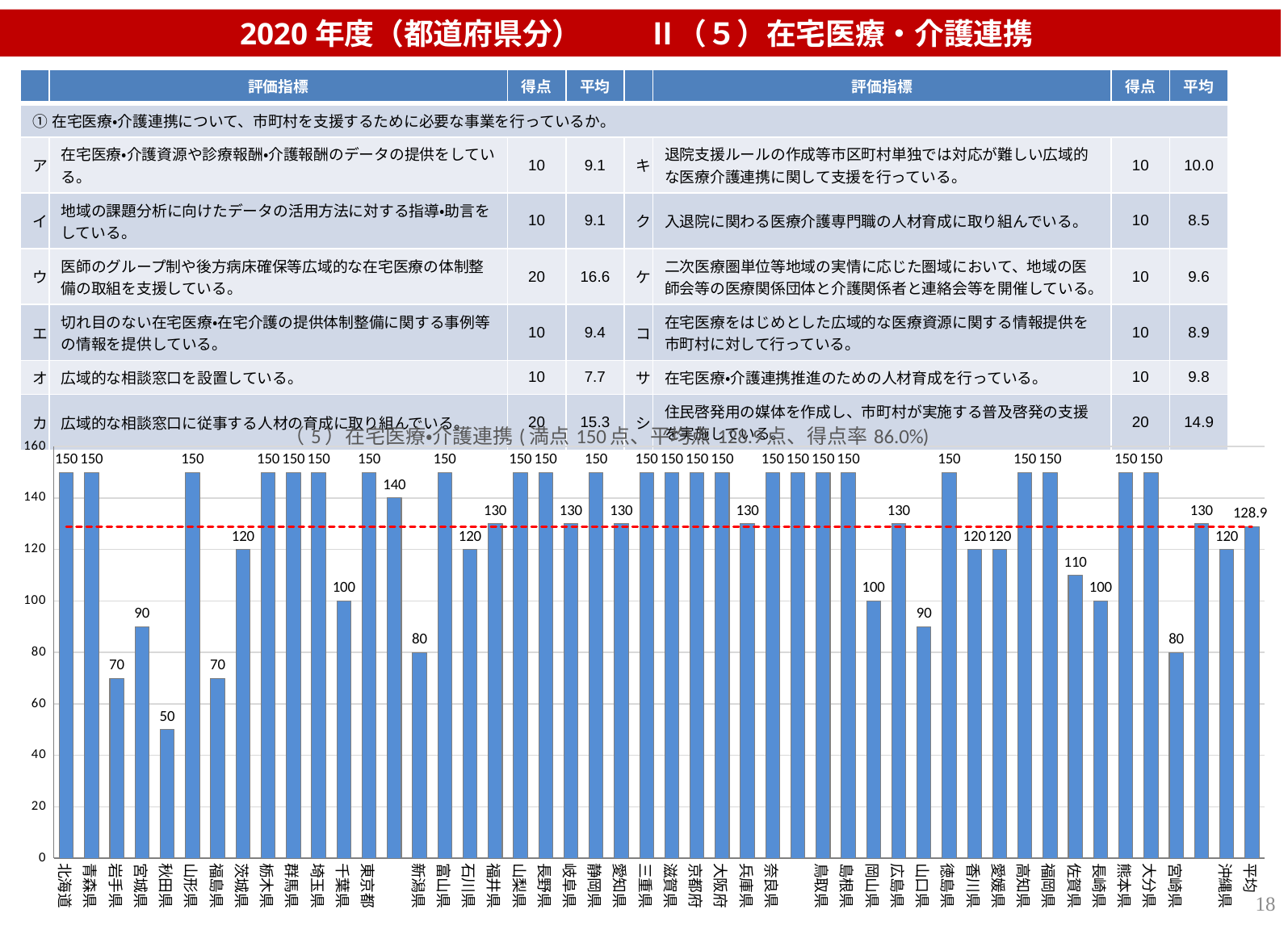
Is the value for 茨城県 greater or less than 100? greater What is the value shown for 平均 at the right end of the bar chart? 128.9 What is the value for 福井県 in the bar chart? 130 What is the value for 秋田県 in the bar chart? 50 What type of chart is shown at the bottom of the slide? bar chart What value does the red dashed horizontal line in the bar chart mark? 128.9 What is the value for 千葉県 in the bar chart? 100 Which prefecture has the lowest value in the bar chart? 秋田県 Which has a larger value, 千葉県 or 宮崎県? 千葉県 What is the difference between the values for 北海道 and 新潟県? 70 What is the value for 佐賀県 in the bar chart? 110 What is the difference between the values for 宮城県 and 岩手県? 20